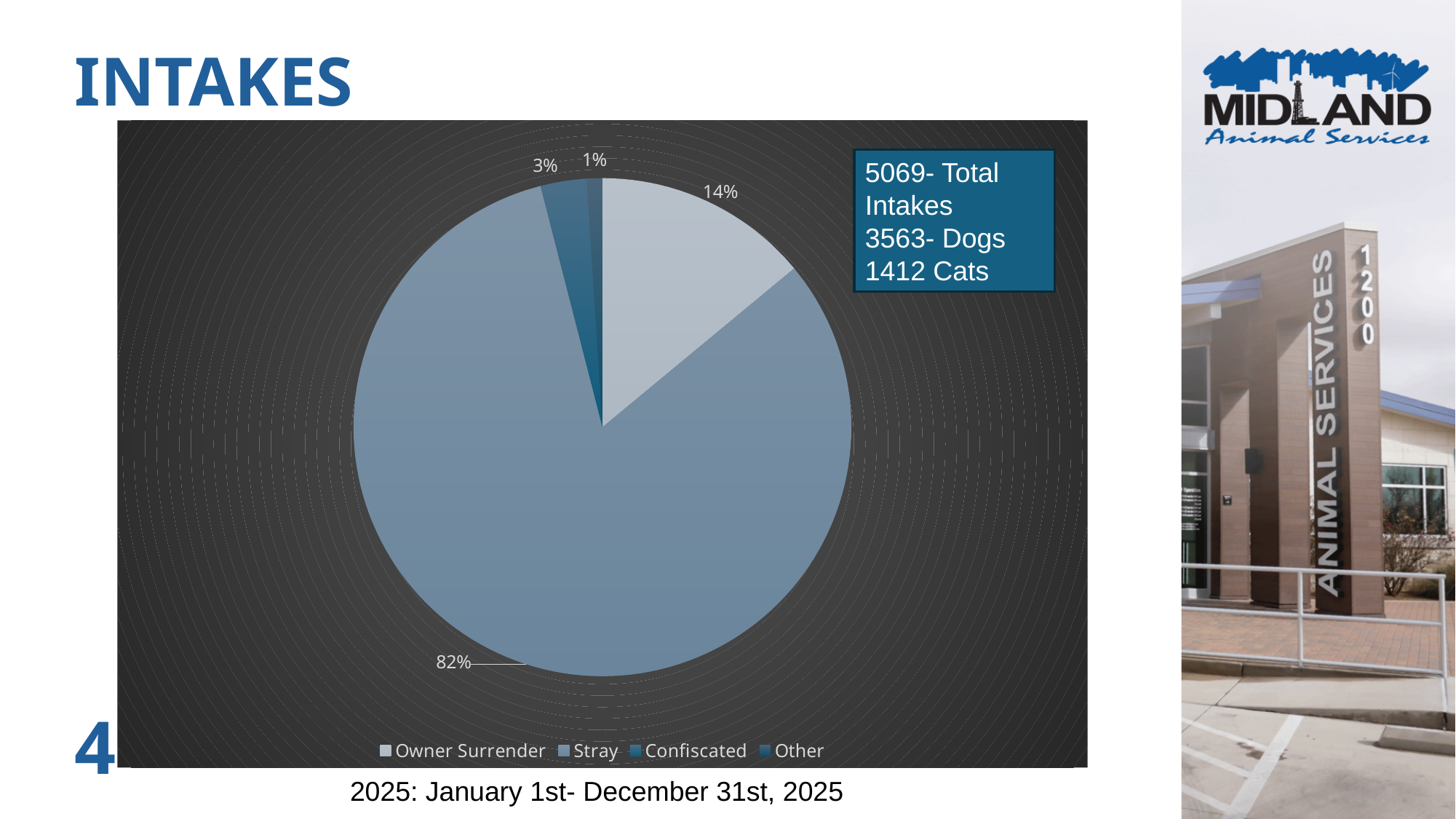
What share of intakes is Confiscated? 3% What share of intakes is Other? 1% How many categories does the pie chart show? 4 Which is larger, the Confiscated share or the Other share? Confiscated What kind of chart is shown on the slide? Pie chart What is the title of the slide containing the pie chart? INTAKES What share of intakes is Stray? 82% What is the total number of intakes stated on the slide? 5069 What is the difference in percentage points between Stray and Owner Surrender? 68 Which intake category has the largest share? Stray Which intake category has the smallest share? Other